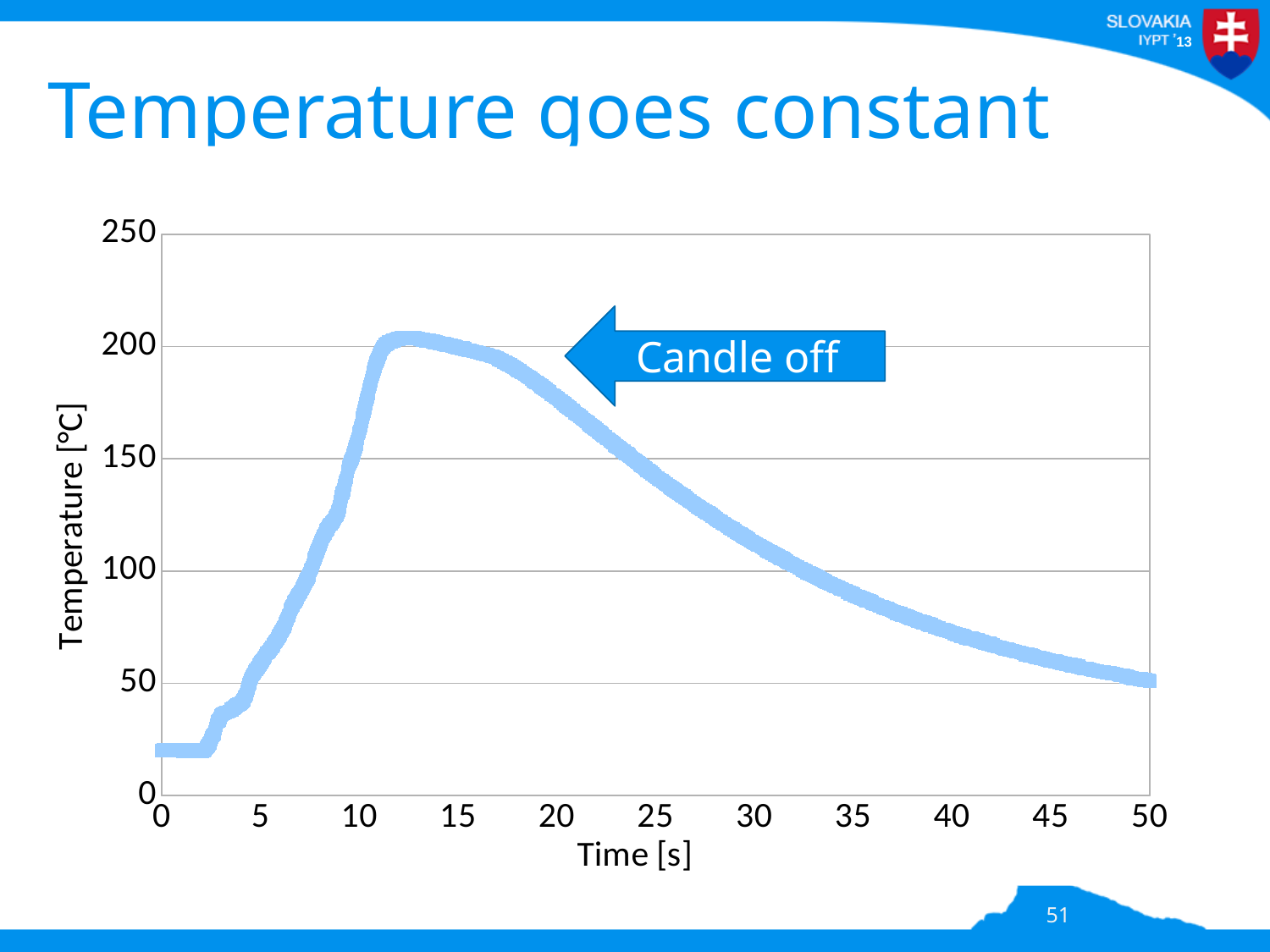
Does the temperature rise or fall between 20 s and 50 s? fall Is the peak temperature greater or less than 150? greater What is the title of the chart slide? Temperature goes constant Is the temperature at 0 s greater or less than 50? less Is the temperature at 50 s greater or less than 100? less What label is on the x axis of the chart? Time [s] What kind of chart is shown on the slide? line chart Does the temperature rise or fall between 5 s and 10 s? rise